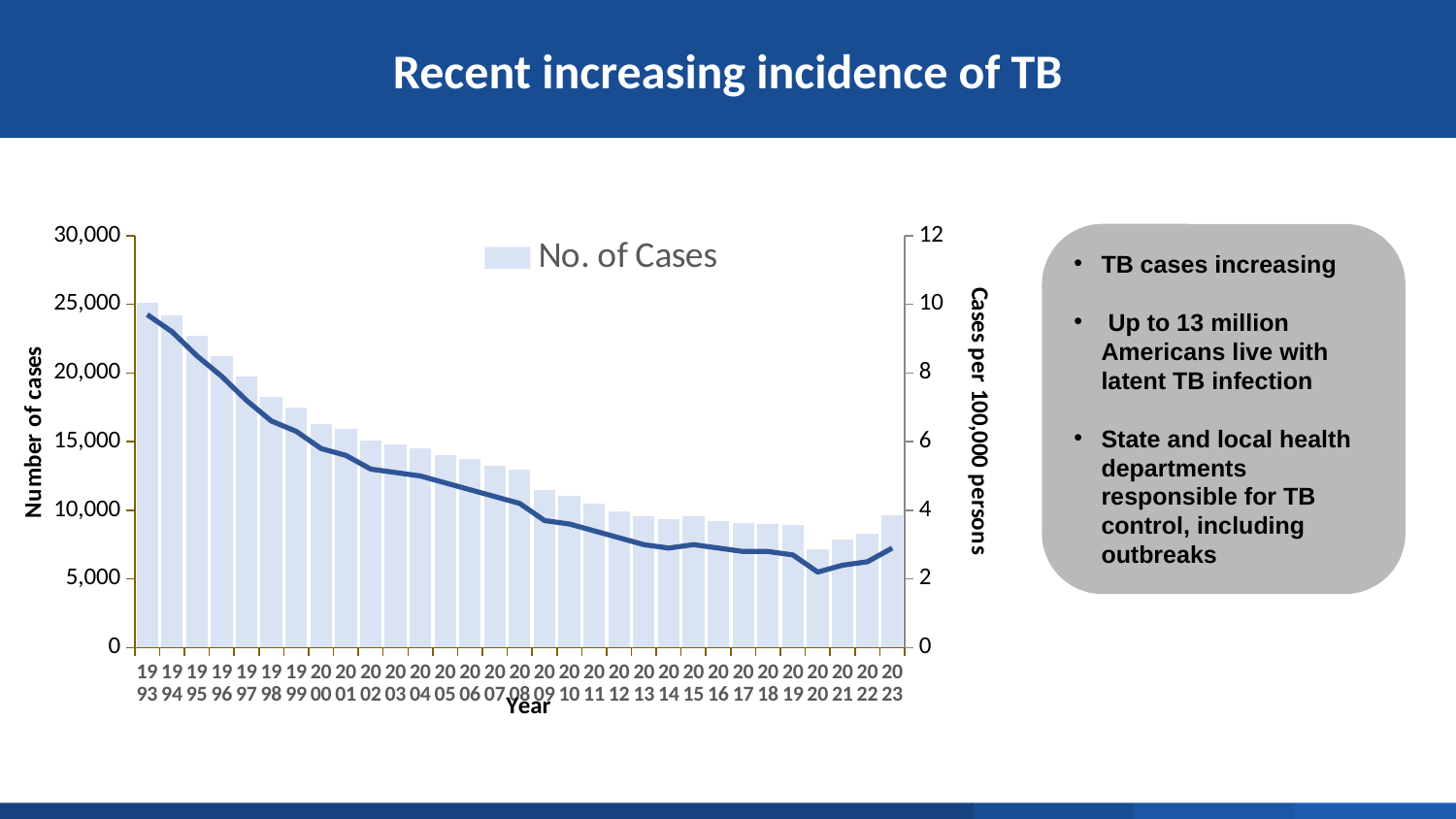
Is the number of cases in 2000 greater or less than 15,000? greater Which year has the lowest number of cases (shortest bar)? 2020 How many years are shown on the x axis? 31 Is the number of cases in 2020 greater or less than 10,000? less Is the cases per 100,000 persons value for 2020 greater or less than 4? less How many series does the legend list? 1 Which year has the highest number of cases (tallest bar)? 1993 What kind of chart is shown? A bar chart combined with a line chart Which year has more cases, 1995 or 2010? 1995 What is the overall trend in the number of cases from 1993 to 2020? Falling